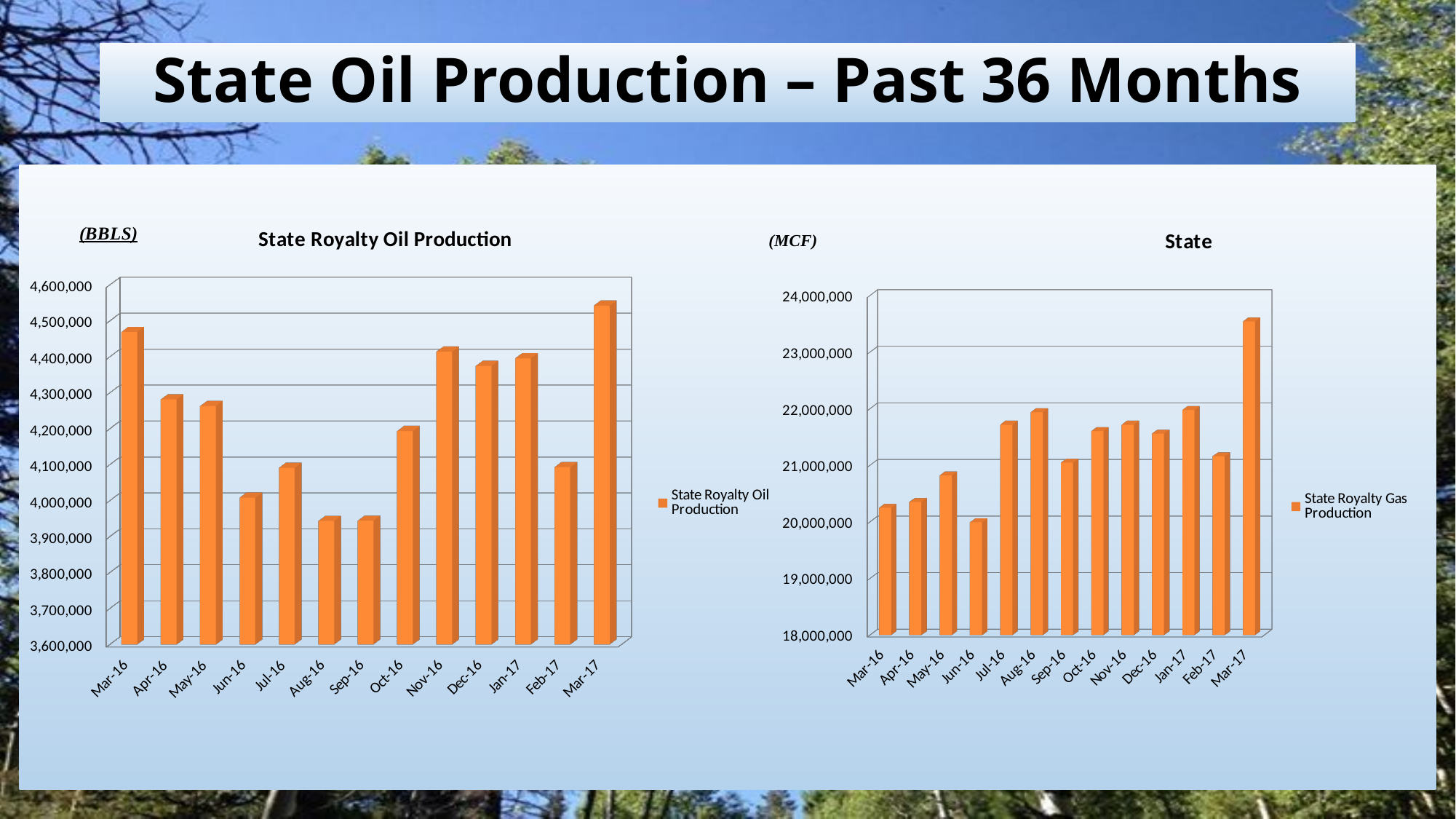
In the State Royalty Oil Production chart on the left, which is larger, the value for Mar-16 or the value for Apr-16? Mar-16 In the chart on the right titled State, what series does the legend list? State Royalty Gas Production In the State Royalty Oil Production chart on the left, is the value for Aug-16 greater or less than 4,000,000? less In the State Royalty Oil Production chart on the left, what unit is shown above the chart? (BBLS) In the chart on the right titled State, is the value for Mar-17 greater or less than 23,000,000? greater What type of chart is the State Royalty Oil Production chart on the left? bar chart In the chart on the right titled State, which month has the lowest value? Jun-16 In the State Royalty Oil Production chart on the left, how many months are plotted? 13 In the chart on the right titled State, which month has the highest value? Mar-17 In the State Royalty Oil Production chart on the left, is the value for Dec-16 greater or less than 4,400,000? less In the State Royalty Oil Production chart on the left, which month has the highest value? Mar-17